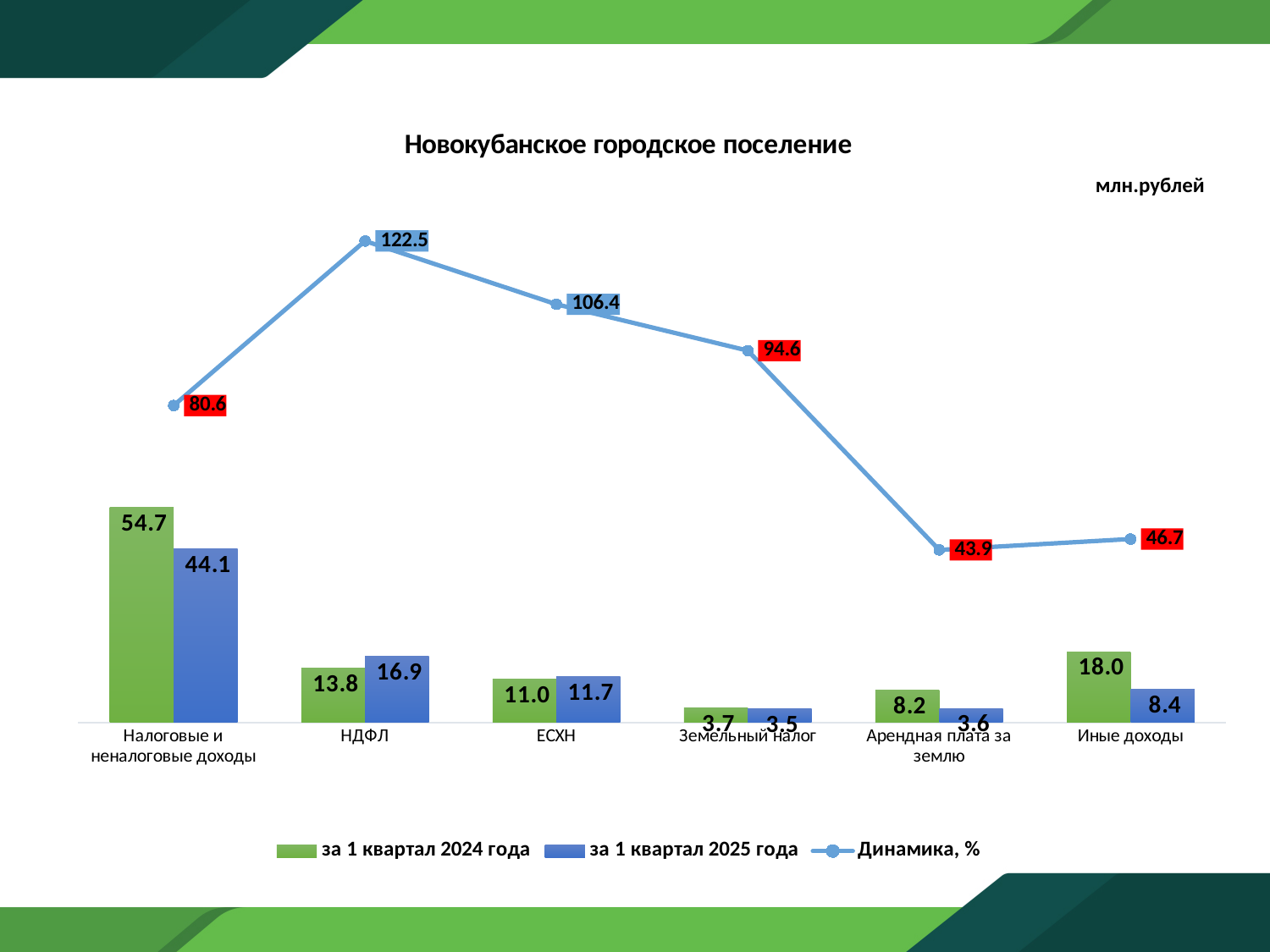
What is the value for Иные доходы in the series 'за 1 квартал 2024 года'? 18.0 What is the title of the chart? Новокубанское городское поселение Which category has the lowest 'Динамика, %' value? Арендная плата за землю How many categories are shown on the x axis? 6 What is the 'Динамика, %' value for ЕСХН? 106.4 Which category has the highest 'Динамика, %' value? НДФЛ What is the difference between the 2024 and 2025 values for Налоговые и неналоговые доходы? 10.6 Which category has the lowest value in the series 'за 1 квартал 2025 года'? Земельный налог What is the difference between the 2024 and 2025 values for Арендная плата за землю? 4.6 Which is larger for ЕСХН: the value for 'за 1 квартал 2024 года' or 'за 1 квартал 2025 года'? за 1 квартал 2025 года What is the value for НДФЛ in the series 'за 1 квартал 2025 года'? 16.9 How many series does the legend list? 3